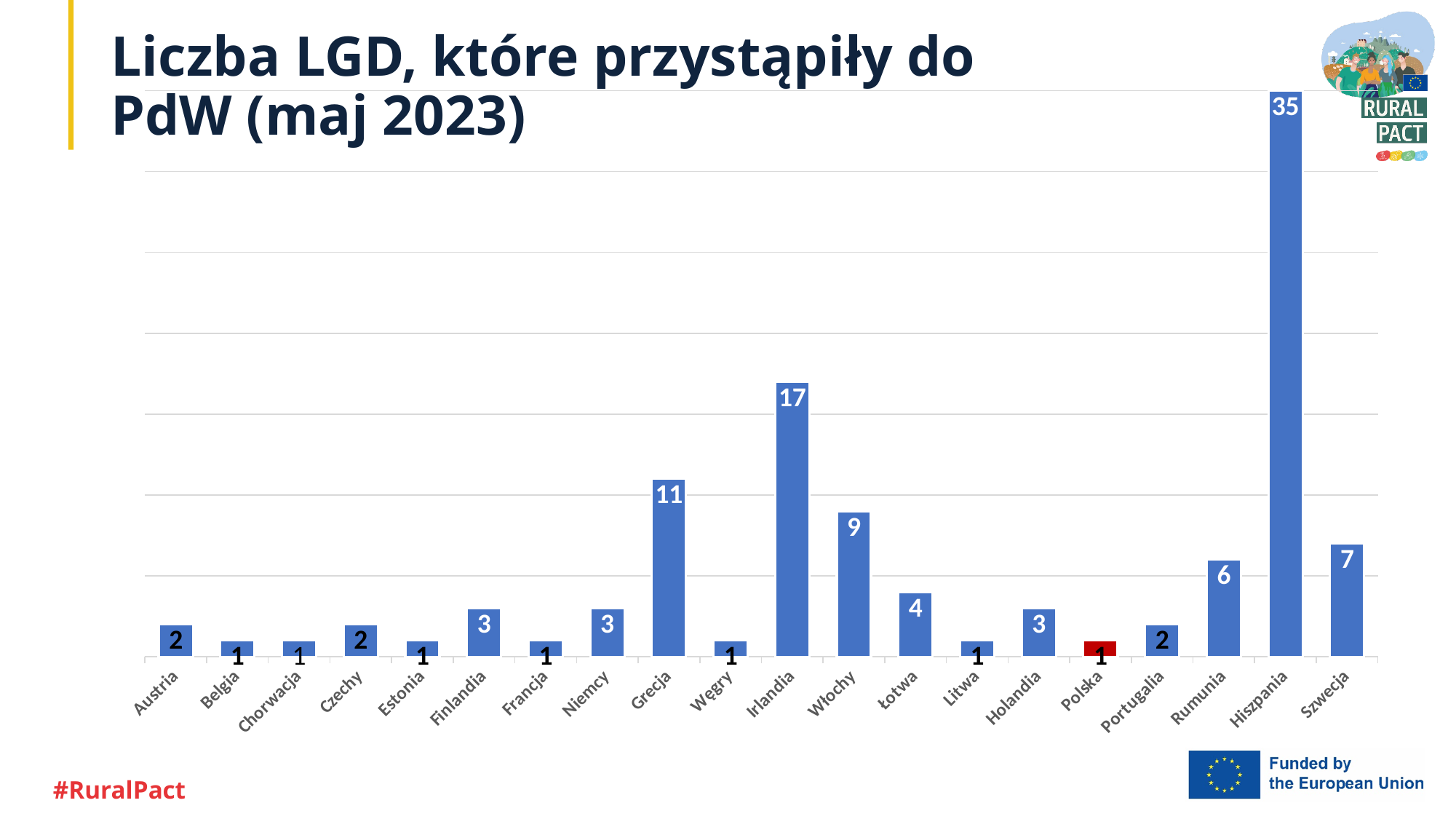
What is the value shown for Polska? 1 What type of chart is shown on the slide? bar chart How many countries are shown on the x axis of the chart? 20 How many LGDs does the chart show for Hiszpania? 35 What is the value shown for Irlandia? 17 What is the difference between the values for Włochy and Rumunia? 3 Which has a larger value, Grecja or Włochy? Grecja Which country's bar is coloured red instead of blue? Polska What is the difference between the values for Hiszpania and Irlandia? 18 What is the value shown for Grecja? 11 Which country has the highest value in the chart? Hiszpania Which has a larger value, Szwecja or Łotwa? Szwecja